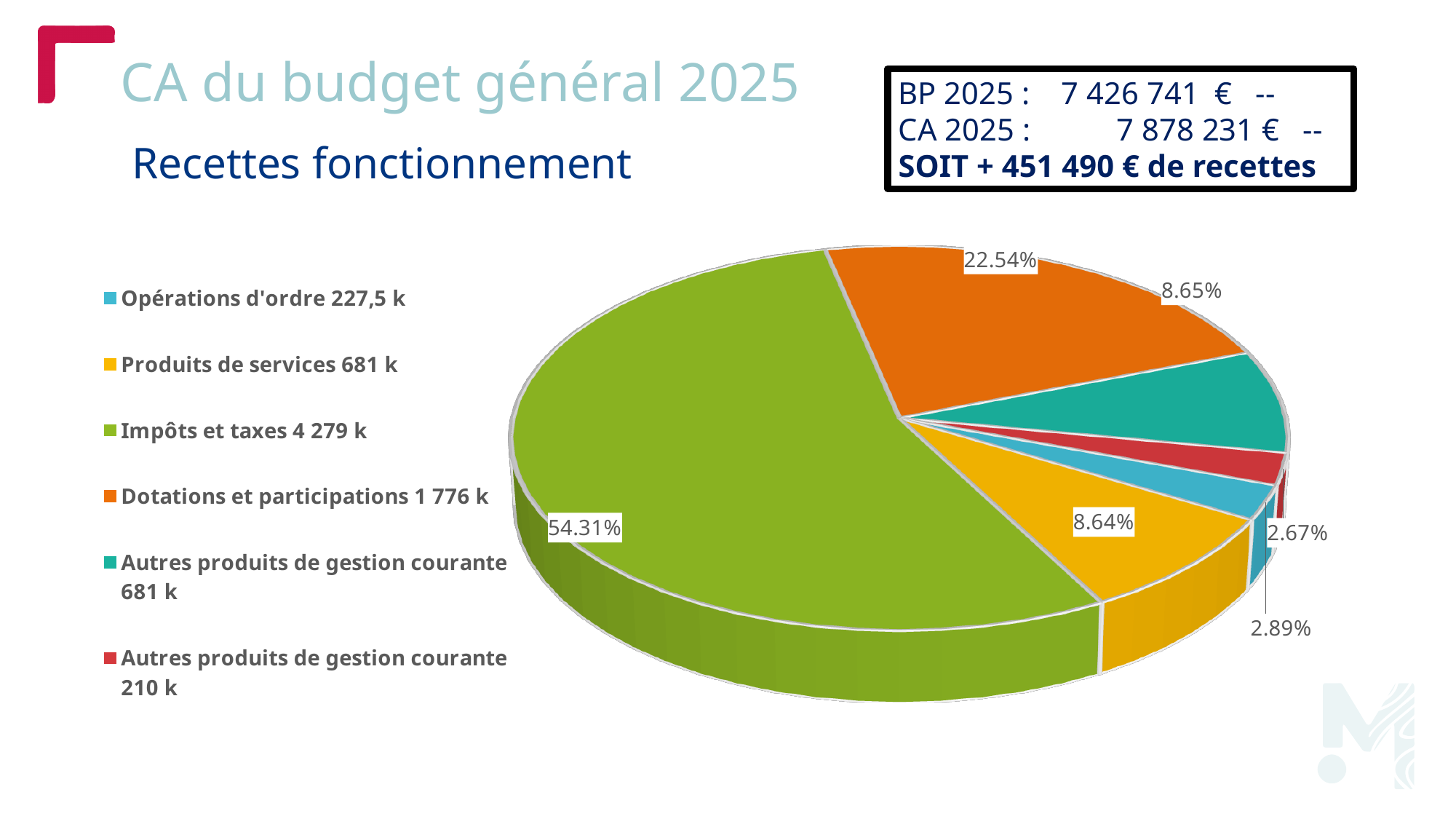
How many categories does the legend of the pie chart list? 6 What value does the legend give for Impôts et taxes? 4 279 k Which category has the largest slice of the pie? Impôts et taxes What share of the pie does Dotations et participations represent? 22.54% What kind of chart is shown on the slide? pie chart What share of the pie does Produits de services represent? 8.64% Which is larger, the slice for Dotations et participations or the slice for Produits de services? Dotations et participations What share of the pie does Impôts et taxes represent? 54.31% What value does the legend give for Opérations d'ordre? 227,5 k What value does the legend give for Dotations et participations? 1 776 k What colour is the slice for Impôts et taxes? green